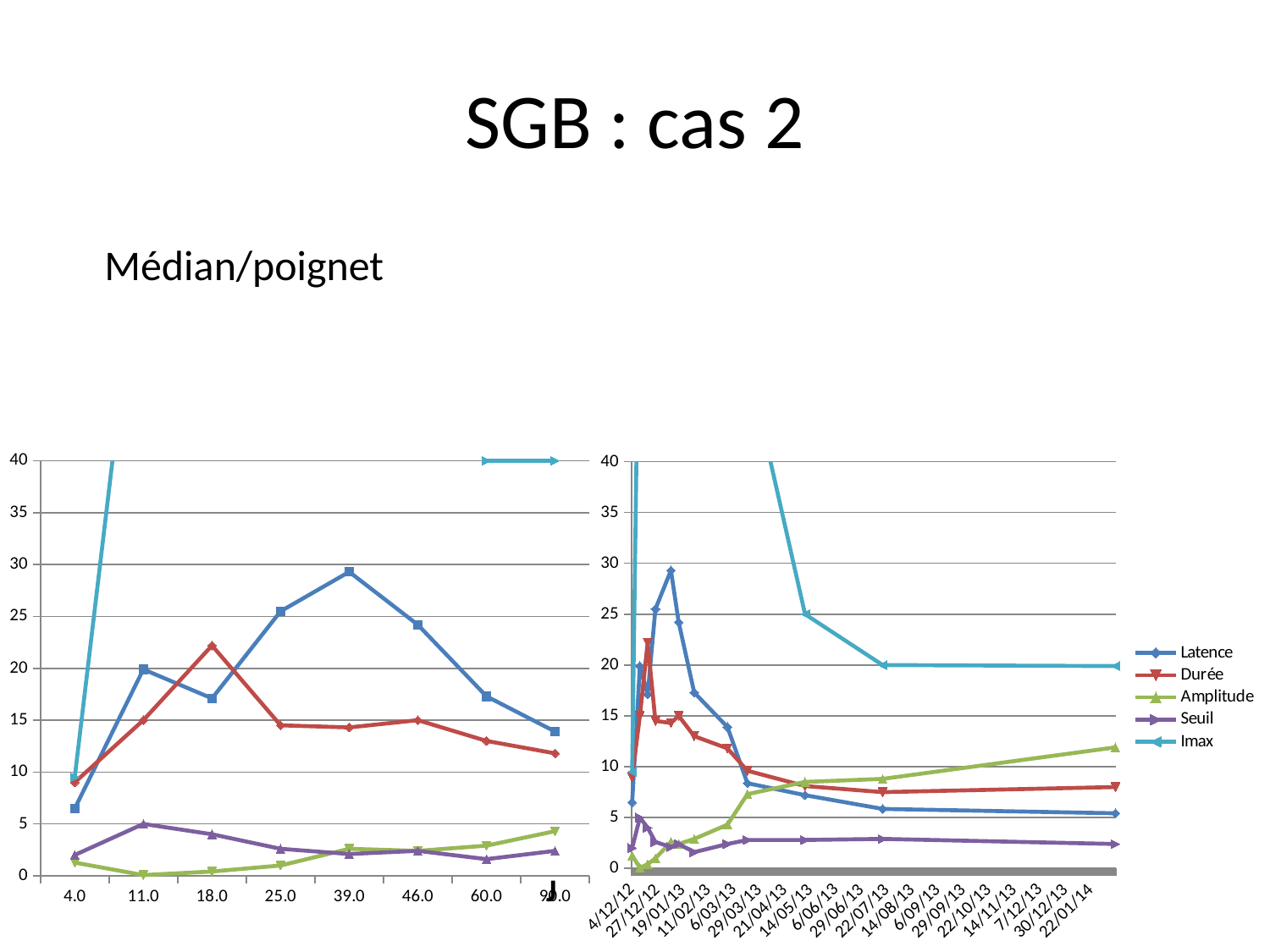
In the left chart, is the value of the blue line at 39.0 greater or less than 25? greater In the left chart, does the blue line rise or fall from 39.0 to 90.0? fall In the left chart, is the value of the green line at 11.0 greater or less than 5? less In the right chart, does the Amplitude line rise or fall from 29/03/13 to 22/01/14? rise How many x-axis categories does the left chart show? 8 In the left chart, is the value of the red line at 18.0 greater or less than 20? greater How many series does the legend of the right chart list? 5 What is the title of the slide containing the charts? SGB : cas 2 What kind of chart is the left chart on the slide? line chart